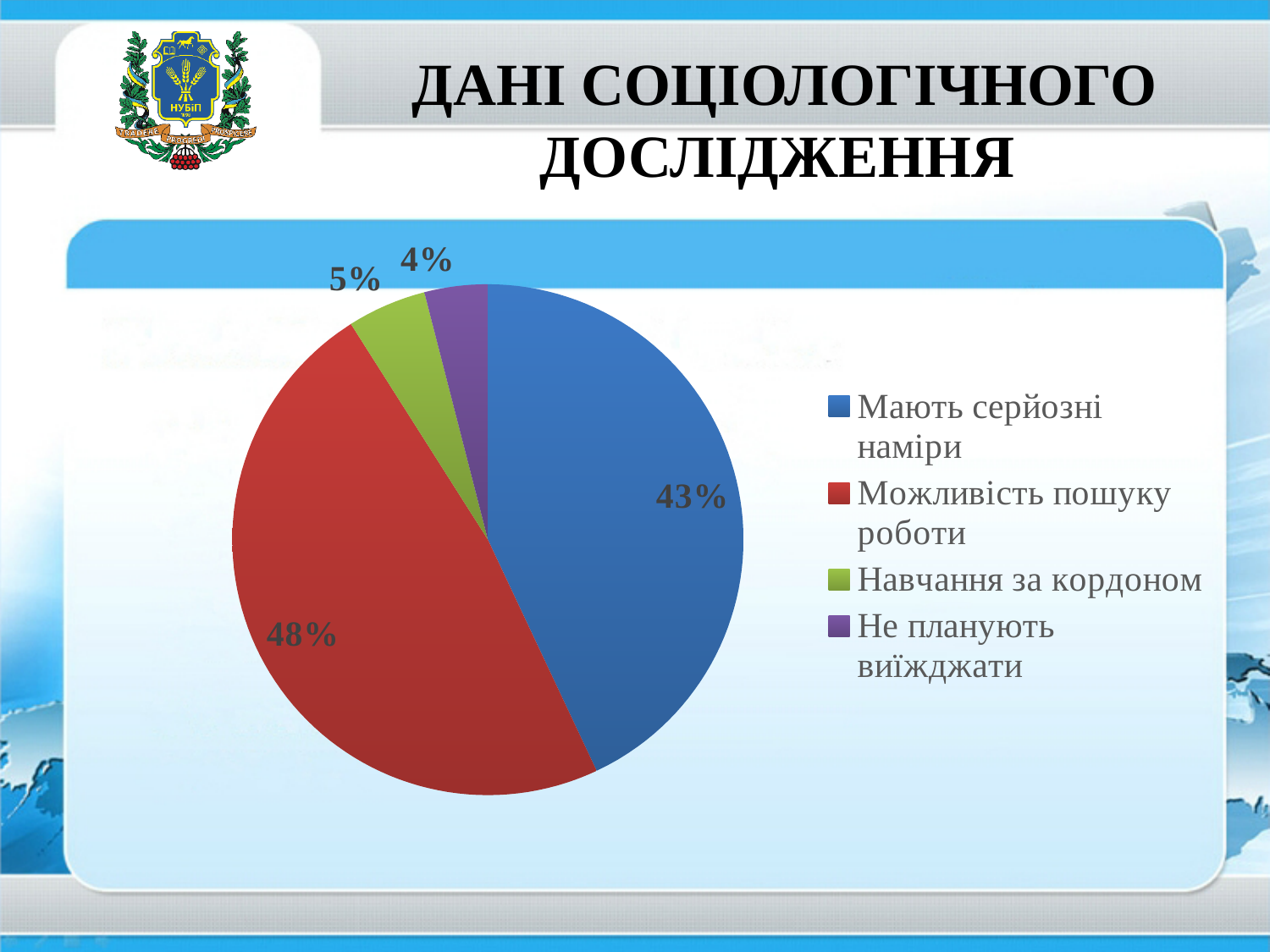
How many categories are shown in the pie chart? 4 Which category has the smallest slice of the pie? Не планують виїжджати What share of the pie does "Можливість пошуку роботи" represent? 48% Which is larger: the slice for "Мають серйозні наміри" or the slice for "Навчання за кордоном"? Мають серйозні наміри What kind of chart is shown on the slide? Pie chart What share of the pie does "Навчання за кордоном" represent? 5% What is the title of the slide containing the chart? ДАНІ СОЦІОЛОГІЧНОГО ДОСЛІДЖЕННЯ What colour is the slice for "Навчання за кордоном"? Green What is the difference in percentage points between "Можливість пошуку роботи" and "Мають серйозні наміри"? 5 Which category has the largest slice of the pie? Можливість пошуку роботи What share of the pie does "Не планують виїжджати" represent? 4%